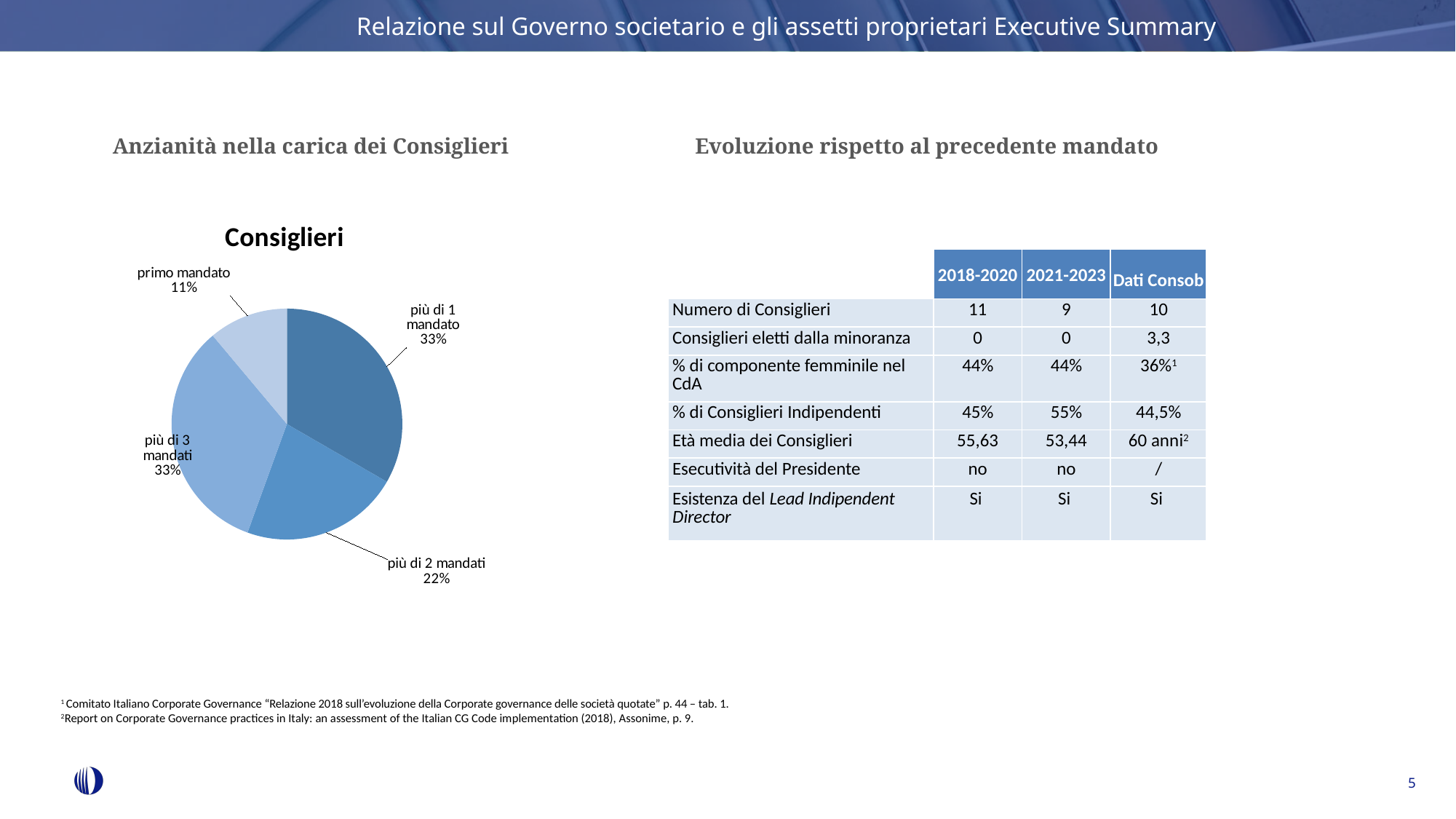
How many slices does the "Consiglieri" pie chart have? 4 Which slice of the "Consiglieri" pie chart is the smallest? primo mandato In the "Consiglieri" pie chart, what share is labelled for "primo mandato"? 11% In the "Consiglieri" pie chart, what is the difference in percentage points between "più di 1 mandato" and "primo mandato"? 22 In the "Consiglieri" pie chart, which is larger: "più di 1 mandato" or "più di 2 mandati"? più di 1 mandato What is the title of the pie chart on the slide? Consiglieri In the "Consiglieri" pie chart, what share is labelled for "più di 3 mandati"? 33% In the "Consiglieri" pie chart, what share is labelled for "più di 1 mandato"? 33% What kind of chart is the "Consiglieri" chart? pie chart In the "Consiglieri" pie chart, which is larger: "più di 2 mandati" or "primo mandato"? più di 2 mandati In the "Consiglieri" pie chart, what is the difference in percentage points between "più di 3 mandati" and "più di 2 mandati"? 11